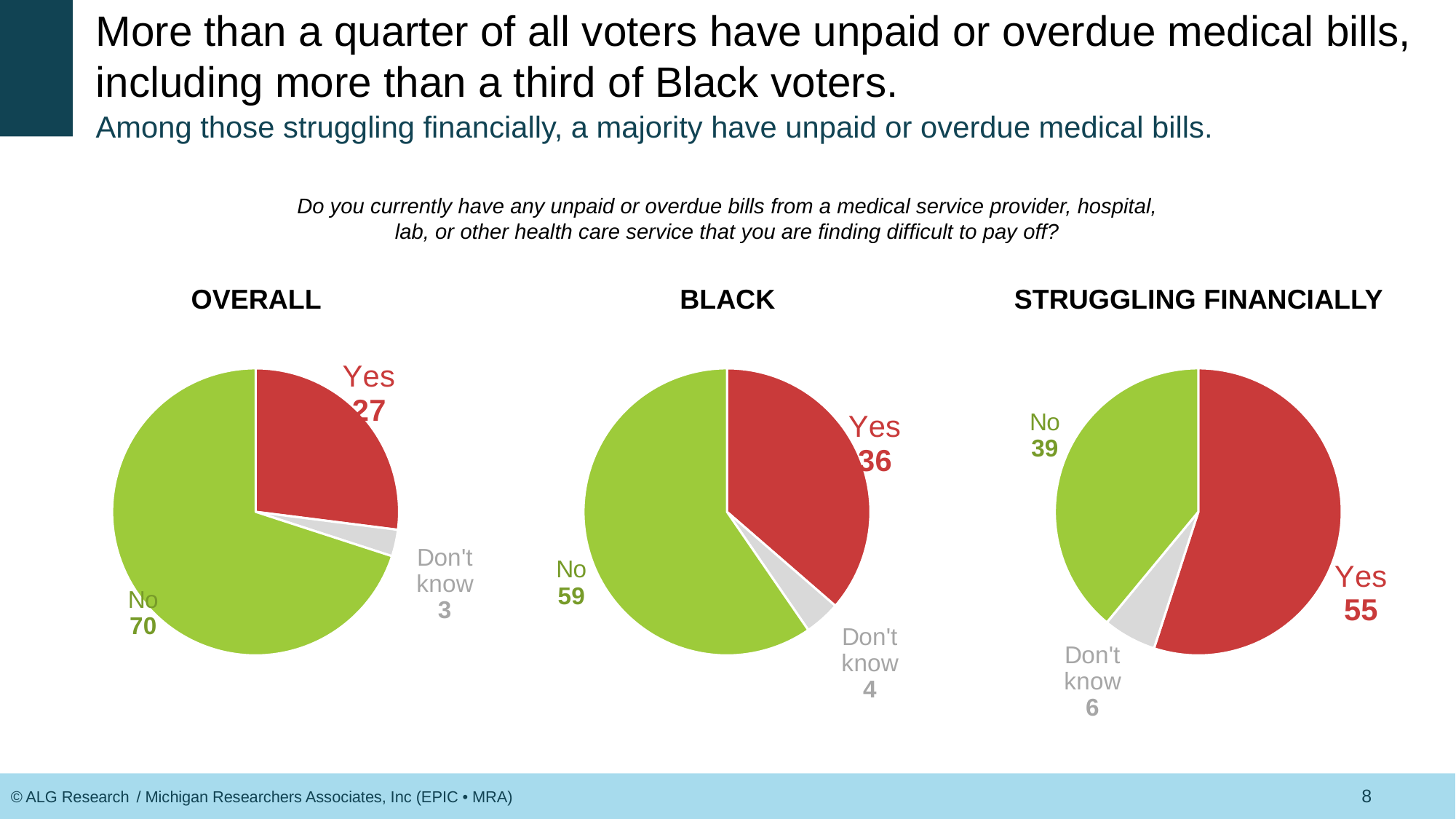
In the BLACK pie chart, what is the difference between the No and Yes values? 23 In the OVERALL pie chart, what is the value for Yes? 27 In the OVERALL pie chart, what is the difference between the No and Yes values? 43 What kind of chart is used for the BLACK group? Pie chart In the STRUGGLING FINANCIALLY pie chart, which slice is the smallest? Don't know In the STRUGGLING FINANCIALLY pie chart, what is the value for Don't know? 6 In the STRUGGLING FINANCIALLY pie chart, which is larger, Yes or No? Yes How many pie charts are shown on the slide? 3 How many slices does the OVERALL pie chart have? 3 What colour is the Yes slice in the STRUGGLING FINANCIALLY pie chart? Red In the OVERALL pie chart, which slice is the largest? No In the BLACK pie chart, what is the value for No? 59